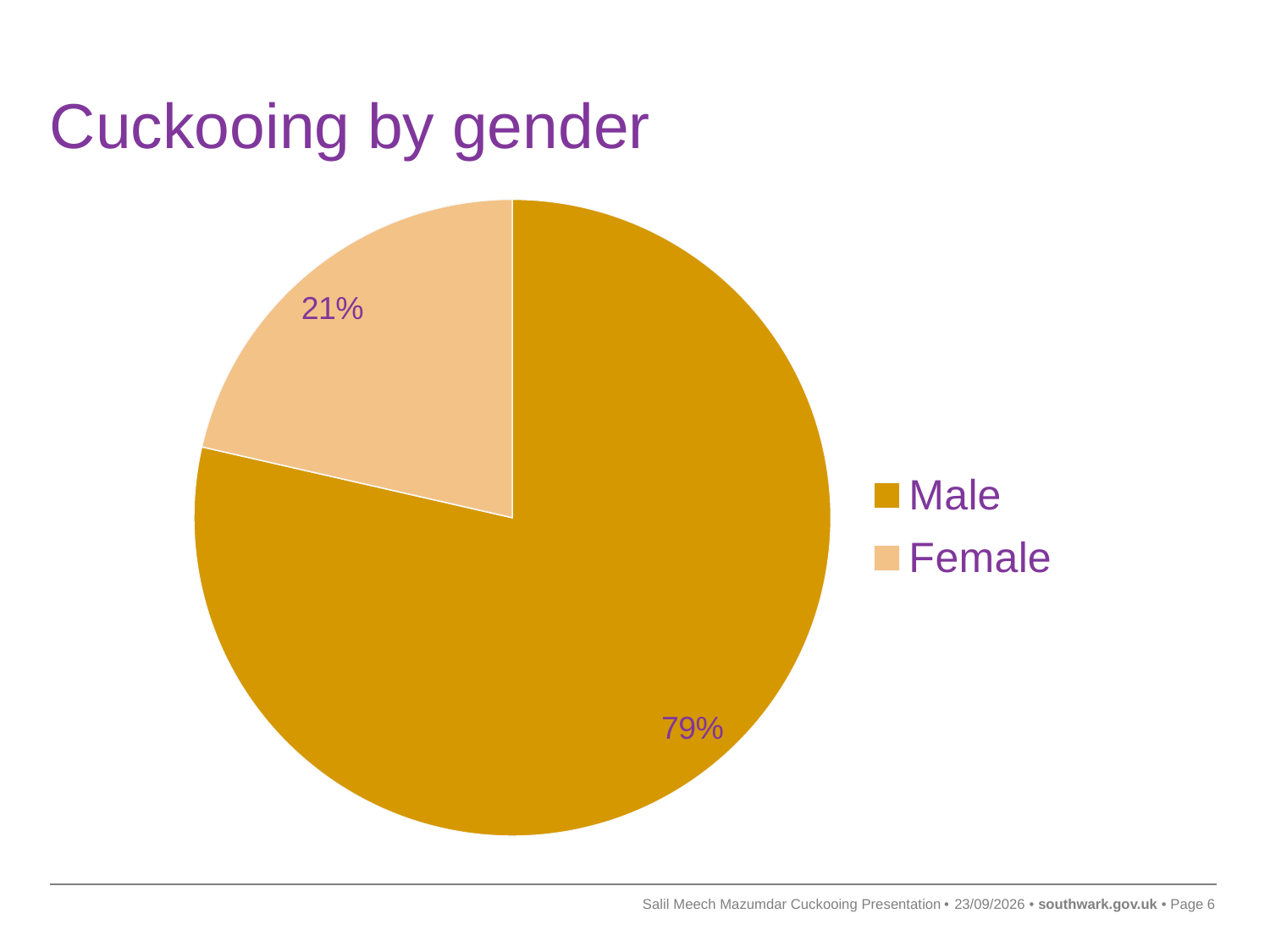
Which share is larger, Male or Female? Male What kind of chart is shown on the slide? Pie chart What percentage of the pie chart is Female? 21% How many entries does the legend list? 2 Which category is shown in the lighter colour in the pie chart? Female How many categories does the pie chart show? 2 What is the title of the slide? Cuckooing by gender What is the difference in percentage points between the Male and Female shares? 58 Which gender has the largest share of the pie chart? Male Which gender has the smallest share of the pie chart? Female What percentage of the pie chart is Male? 79%